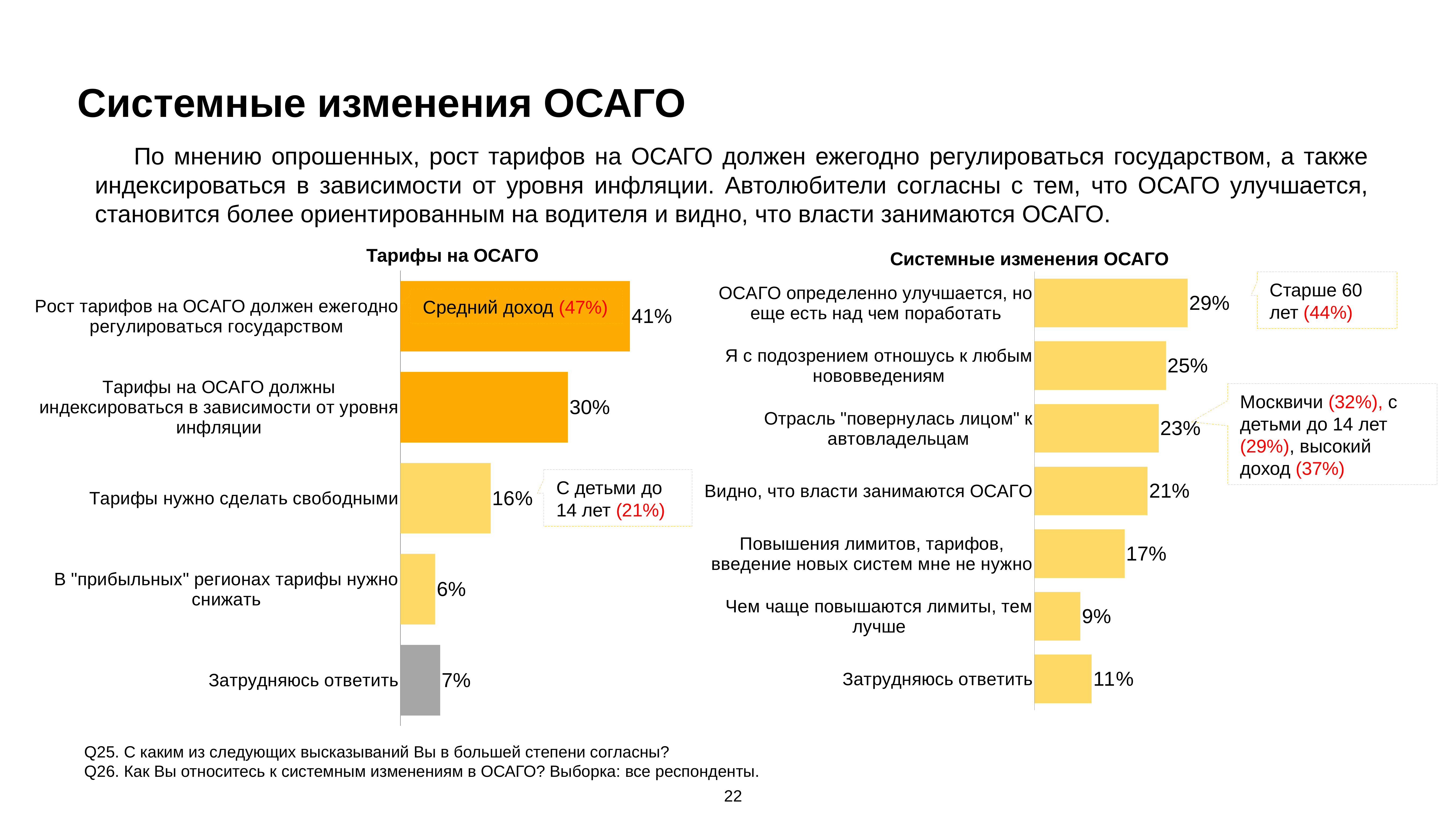
In the 'Системные изменения ОСАГО' chart, what is the difference between 'Я с подозрением отношусь к любым нововведениям' and 'Повышения лимитов, тарифов, введение новых систем мне не нужно'? 8% In the 'Тарифы на ОСАГО' chart, which category has the lowest value? В "прибыльных" регионах тарифы нужно снижать In the 'Системные изменения ОСАГО' chart, how many categories are shown? 7 In the 'Системные изменения ОСАГО' chart, what is the value for 'Видно, что власти занимаются ОСАГО'? 21% In the 'Тарифы на ОСАГО' chart, what is the value for 'Тарифы нужно сделать свободными'? 16% In the 'Тарифы на ОСАГО' chart, how many categories are shown? 5 In the 'Тарифы на ОСАГО' chart, what is the value for 'Рост тарифов на ОСАГО должен ежегодно регулироваться государством'? 41% In the 'Тарифы на ОСАГО' chart, what is the difference between the values for 'Рост тарифов на ОСАГО должен ежегодно регулироваться государством' and 'Тарифы на ОСАГО должны индексироваться в зависимости от уровня инфляции'? 11% What type of chart is the 'Тарифы на ОСАГО' chart? Bar chart In the 'Системные изменения ОСАГО' chart, what is the value for 'Чем чаще повышаются лимиты, тем лучше'? 9% In the 'Системные изменения ОСАГО' chart, which category has the highest value? ОСАГО определенно улучшается, но еще есть над чем поработать In the 'Системные изменения ОСАГО' chart, which is larger: 'Затрудняюсь ответить' or 'Чем чаще повышаются лимиты, тем лучше'? Затрудняюсь ответить